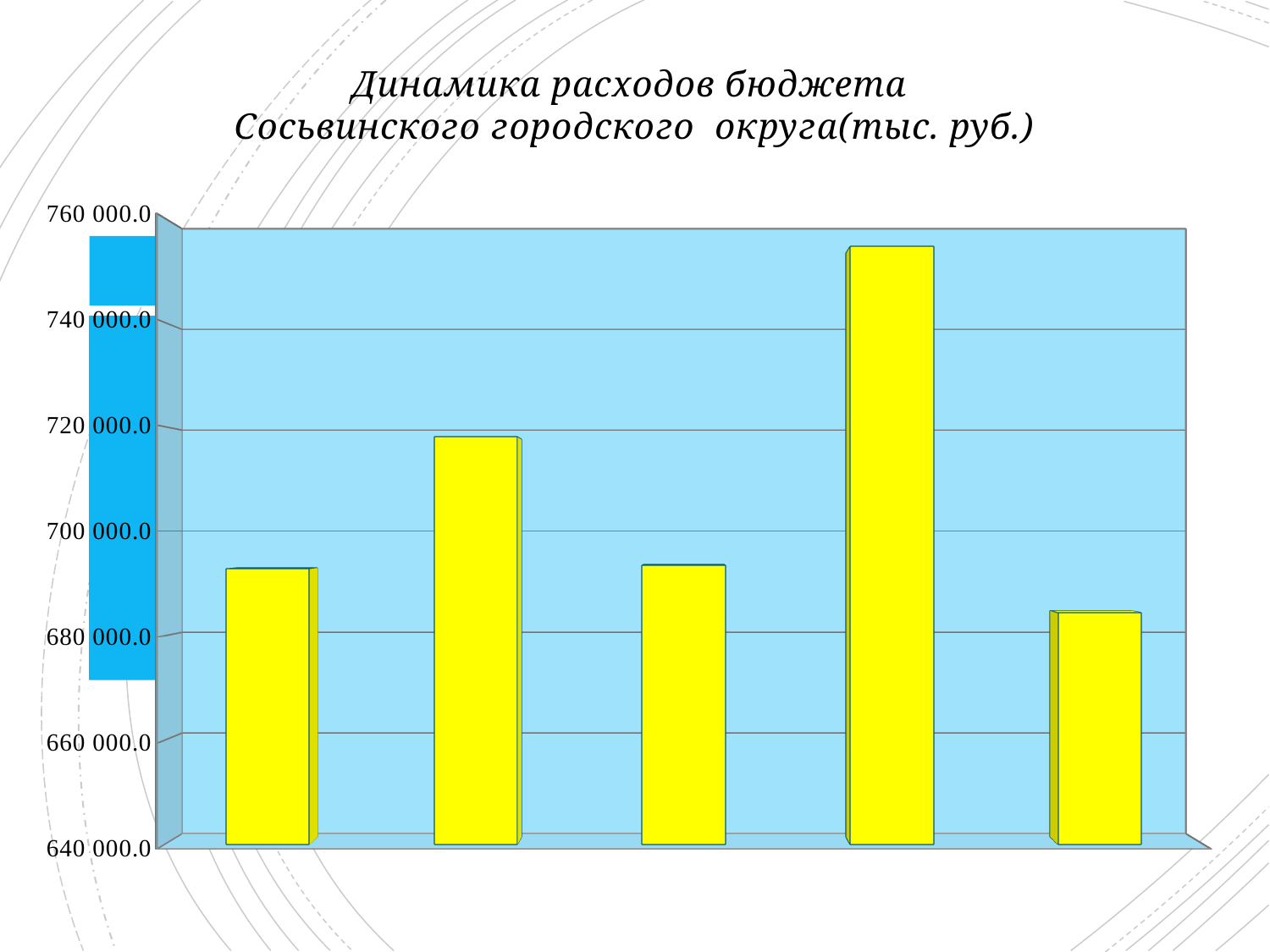
Which is larger, the third bar from the left or the fifth bar from the left? the third bar Is the value of the fifth bar from the left greater or less than 680 000.0? greater What is the title of the chart on the slide? Динамика расходов бюджета Сосьвинского городского округа(тыс. руб.) Is the value of the second bar from the left greater or less than 700 000.0? greater Which is larger, the second bar from the left or the first bar from the left? the second bar Which bar (by position from left) is the lowest in the chart? the fifth bar Is the value of the first bar from the left greater or less than 700 000.0? less What kind of chart is shown on the slide? bar chart Which bar (by position from left) is the highest in the chart? the fourth bar How many bars are plotted in the chart? 5